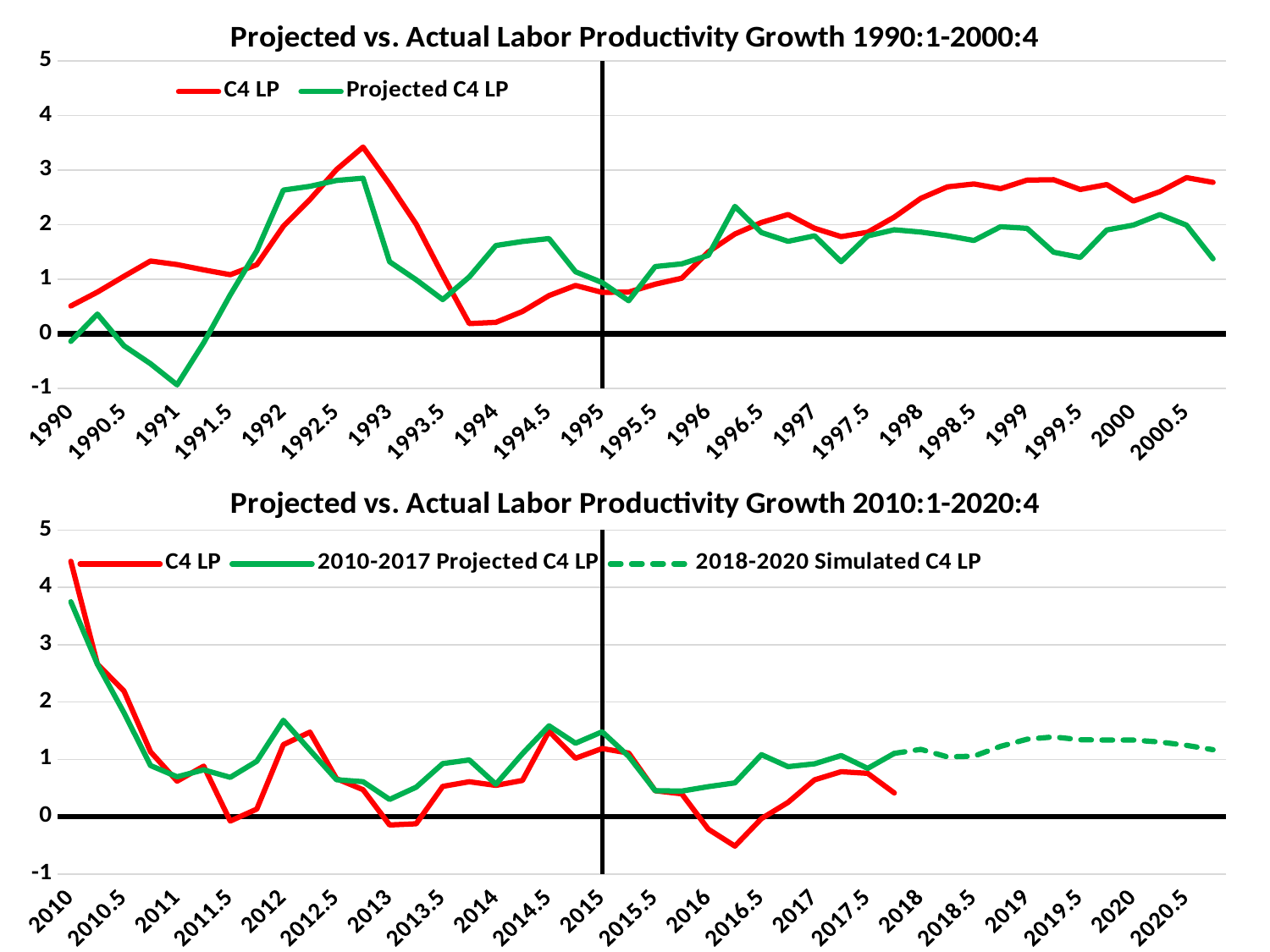
In the bottom chart, which series has the higher value at 2016, C4 LP or 2010-2017 Projected C4 LP? 2010-2017 Projected C4 LP In the bottom chart, is the value of C4 LP at 2010 greater or less than 4? greater In the top chart, is the value of Projected C4 LP at 1991 greater or less than 0? less In the top chart, which series has the higher value at 1994, C4 LP or Projected C4 LP? Projected C4 LP In the top chart, is the value of C4 LP at 1993 greater or less than 3? less How many series does the legend of the top chart list? 2 How many series does the legend of the bottom chart, 'Projected vs. Actual Labor Productivity Growth 2010:1-2020:4', list? 3 What kind of chart is the top chart, 'Projected vs. Actual Labor Productivity Growth 1990:1-2000:4'? Line chart In the bottom chart, does the C4 LP series rise or fall between 2010 and 2011? Fall In the bottom chart, which series is drawn with a dashed line? 2018-2020 Simulated C4 LP In the top chart, which series has the higher value at 1993, C4 LP or Projected C4 LP? C4 LP